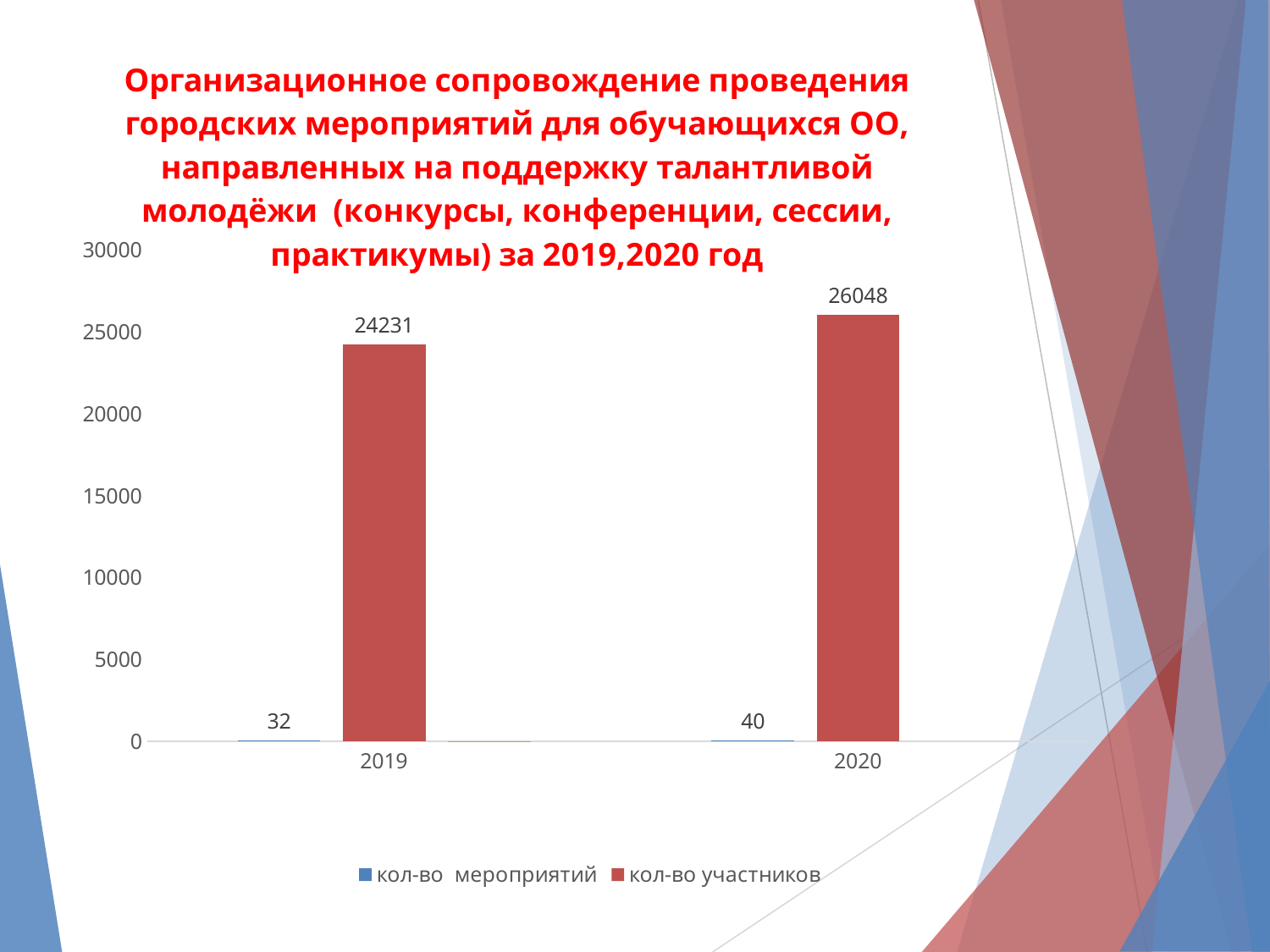
Which year has the higher value for кол-во участников? 2020 What is the value of кол-во мероприятий for 2019? 32 Is the value for кол-во участников in 2019 greater or less than 25000? less What is the difference between кол-во участников in 2020 and in 2019? 1817 What is the value of кол-во мероприятий for 2020? 40 What is the difference between кол-во мероприятий in 2020 and in 2019? 8 What kind of chart is shown on the slide? bar chart What is the value of кол-во участников for 2019? 24231 What is the value of кол-во участников for 2020? 26048 Which year has the lower value for кол-во мероприятий? 2019 How many series does the legend list? 2 Does кол-во участников rise or fall from 2019 to 2020? rise